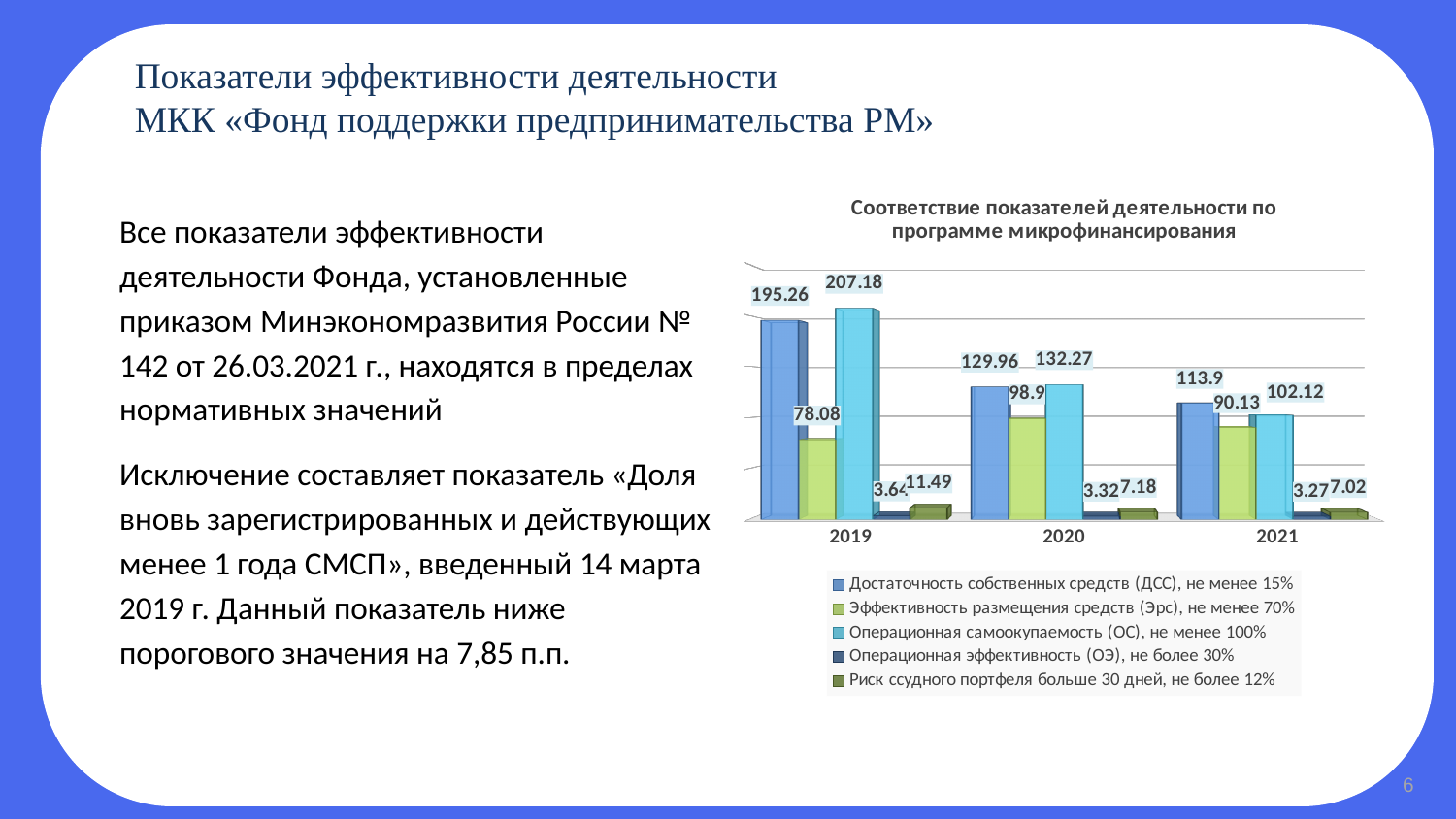
What is the value of Эффективность размещения средств (Эрс) in 2020? 98.9 What is the value of Риск ссудного портфеля больше 30 дней in 2019? 11.49 In which year is Операционная самоокупаемость (ОС) highest? 2019 Does Достаточность собственных средств (ДСС) rise or fall from 2019 to 2021? Fall How many series does the legend list? 5 How many years are shown on the x axis? 3 What kind of chart is shown on the slide? Bar chart In which year is Операционная эффективность (ОЭ) lowest? 2021 What is the difference between Операционная самоокупаемость (ОС) in 2019 and in 2020? 74.91 What is the value of Операционная самоокупаемость (ОС) in 2021? 102.12 Which is larger in 2021: Достаточность собственных средств (ДСС) or Операционная самоокупаемость (ОС)? Достаточность собственных средств (ДСС) What is the value of Достаточность собственных средств (ДСС) in 2019? 195.26